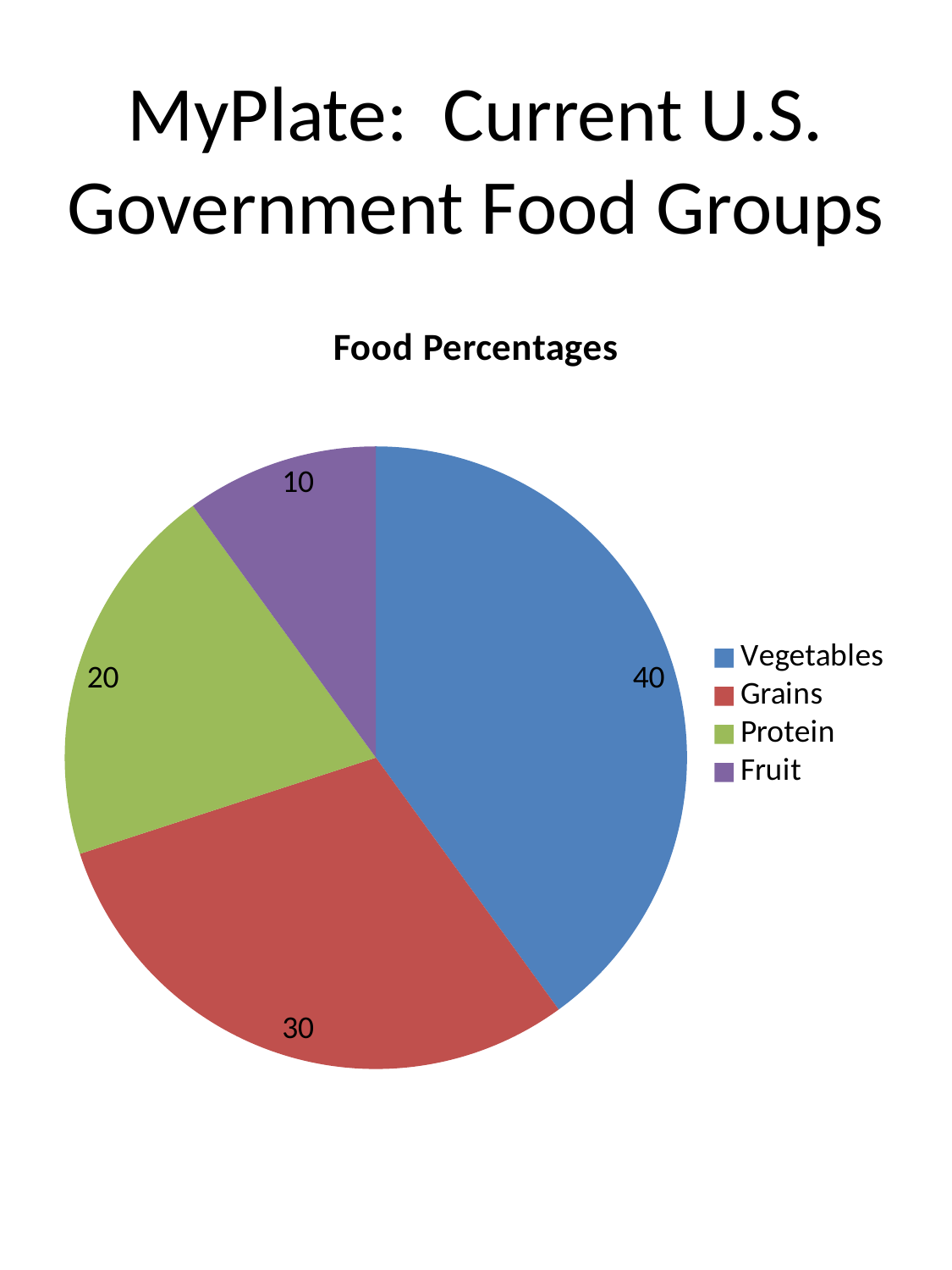
What share of the pie does the Grains slice represent? 30% How many food groups are shown in the pie chart? 4 What is the value for Vegetables in the Food Percentages pie chart? 40 What is the value for Fruit in the Food Percentages pie chart? 10 What is the value for Protein in the Food Percentages pie chart? 20 What is the title of the chart on the slide? Food Percentages What is the value for Grains in the Food Percentages pie chart? 30 What kind of chart is shown on the slide? Pie chart Which food group has the smallest slice in the pie chart? Fruit What is the difference between the values for Vegetables and Fruit? 30 Which is larger, the value for Grains or the value for Protein? Grains Which food group has the largest slice in the pie chart? Vegetables